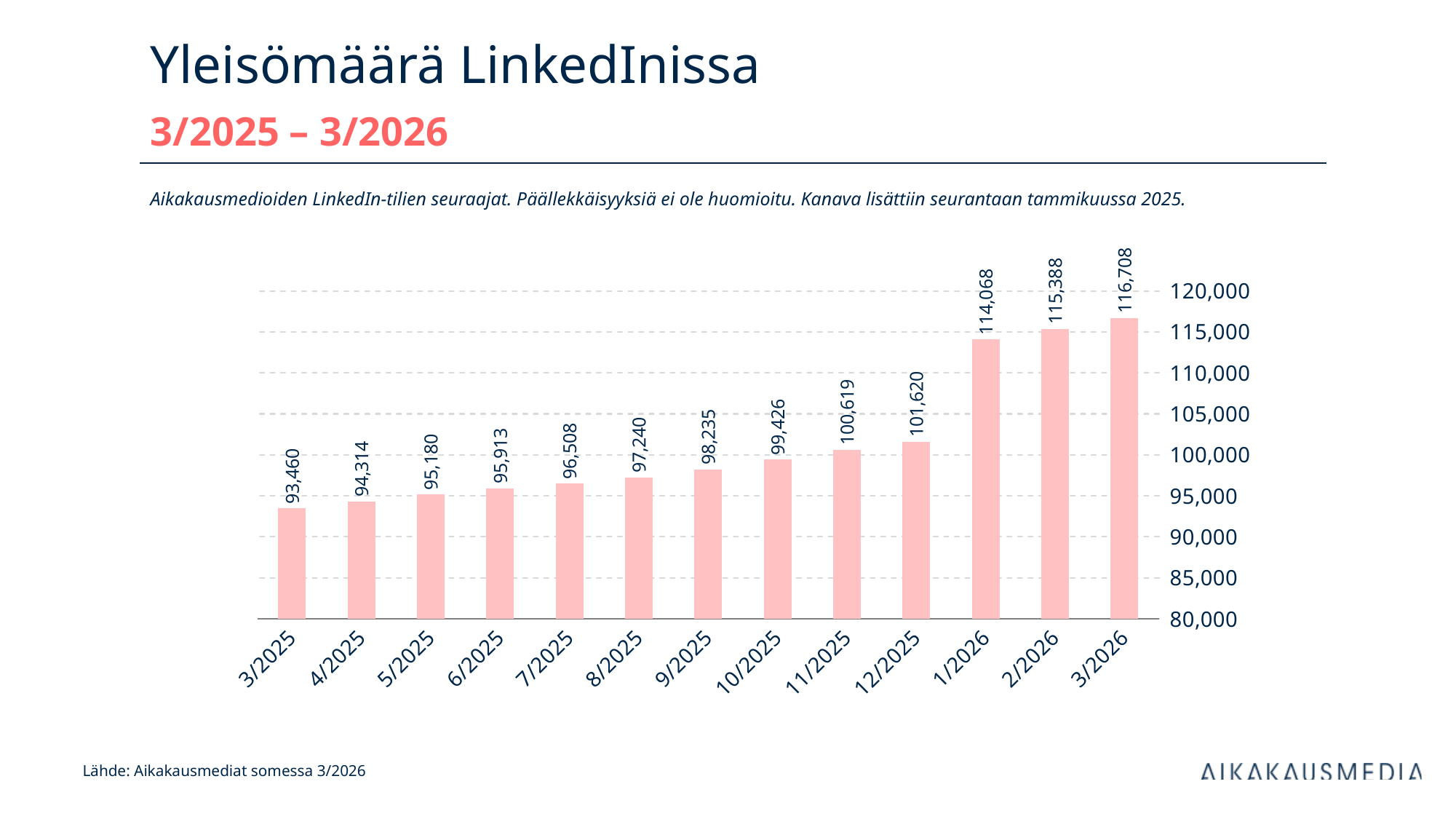
Do the values rise or fall from 3/2025 to 3/2026? rise What is the value for 1/2026? 114,068 Which month has the highest value? 3/2026 What kind of chart is shown on the slide? bar chart Which month has the lowest value? 3/2025 Which is larger, the value for 9/2025 or the value for 11/2025? 11/2025 What is the difference between the values for 1/2026 and 12/2025? 12,448 What is the value for 3/2025? 93,460 What is the value for 12/2025? 101,620 How many months are shown on the x axis? 13 Is the value for 8/2025 greater or less than 100,000? less What is the difference between the values for 3/2026 and 3/2025? 23,248